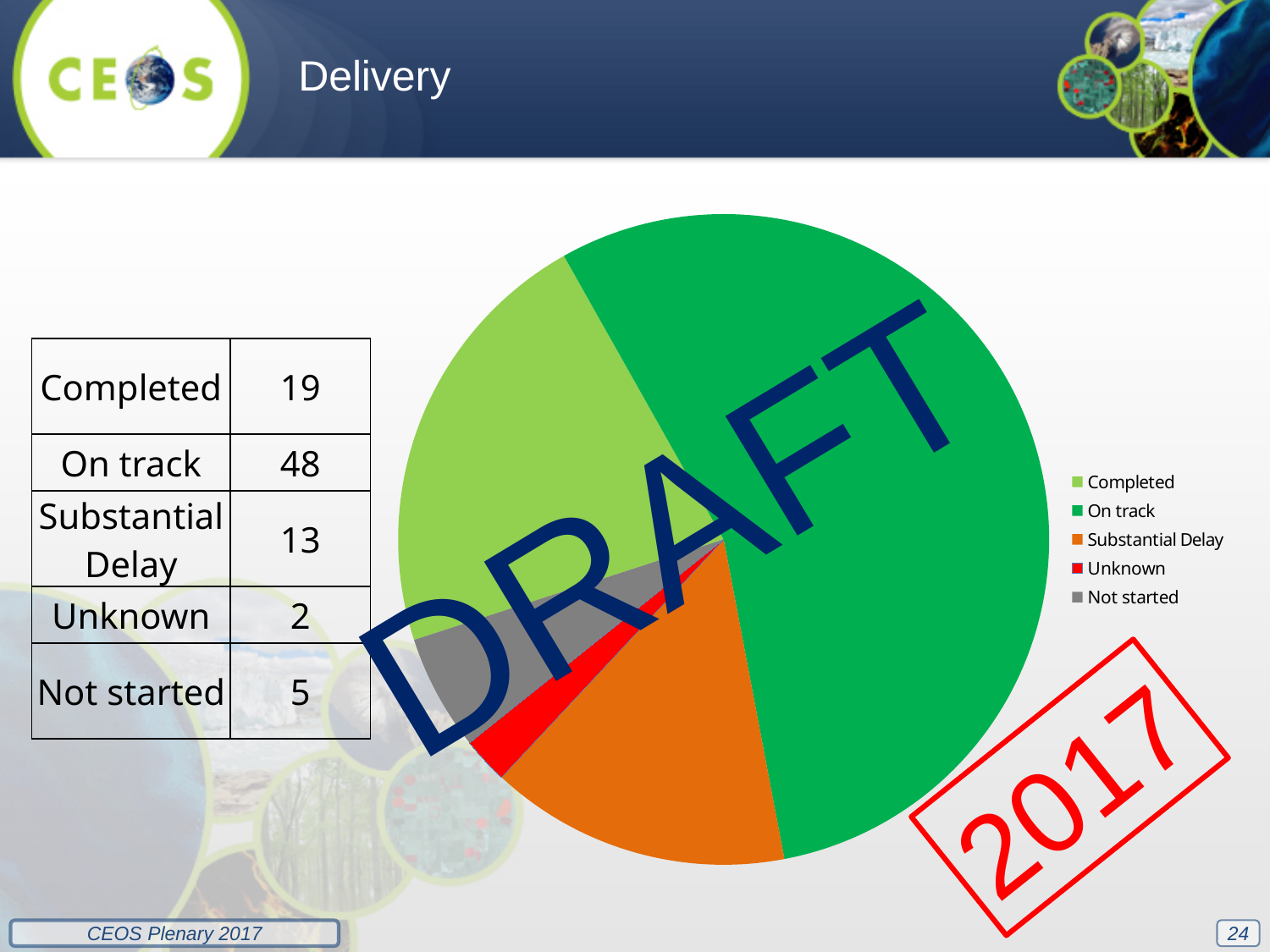
What is the value for Completed? 19 What is the value for Substantial Delay? 13 What is the value for On track? 48 What is the value for Not started? 5 Which category has the smallest slice of the pie chart? Unknown How many entries does the legend of the pie chart list? 5 Which category has the largest slice of the pie chart? On track How many categories does the pie chart have? 5 What is the difference between the On track and Completed values? 29 Which is larger, Substantial Delay or Not started? Substantial Delay What kind of chart is shown on the slide? Pie chart What colour is the Substantial Delay slice in the pie chart? Orange